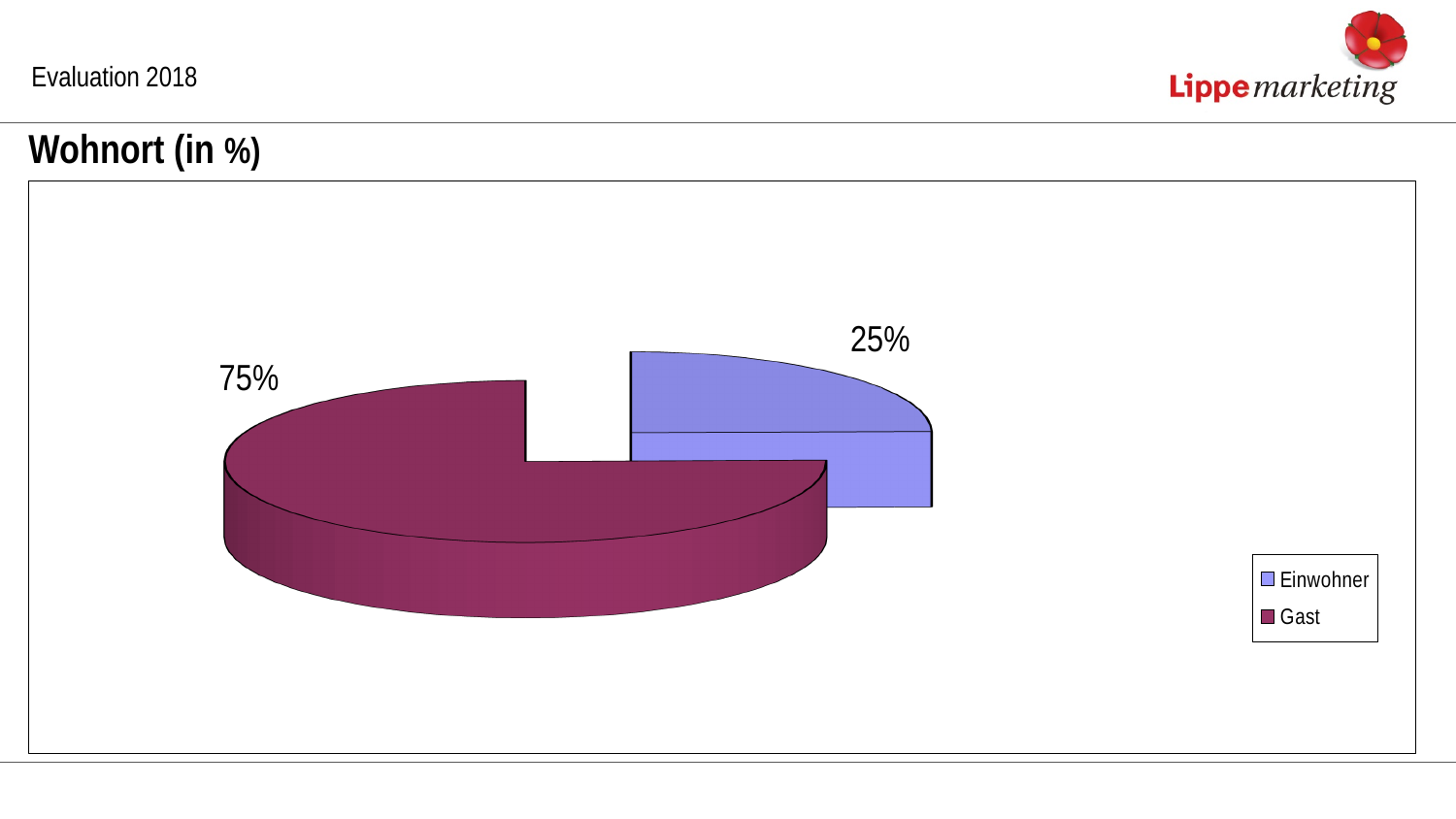
Which slice is larger, Einwohner or Gast? Gast What share of the pie does the Gast slice represent? 75% What is the title of the chart on the slide? Wohnort (in %) Which category has the largest share of the pie chart? Gast What percentage of the pie chart is labelled Einwohner? 25% What percentage of the pie chart is labelled Gast? 75% How many categories does the pie chart show? 2 What kind of chart is shown on the slide? Pie chart Which colour represents Einwohner in the legend? Blue What is the difference in percentage points between the Gast and Einwohner slices? 50 How many entries does the legend list? 2 Which category has the smallest share of the pie chart? Einwohner